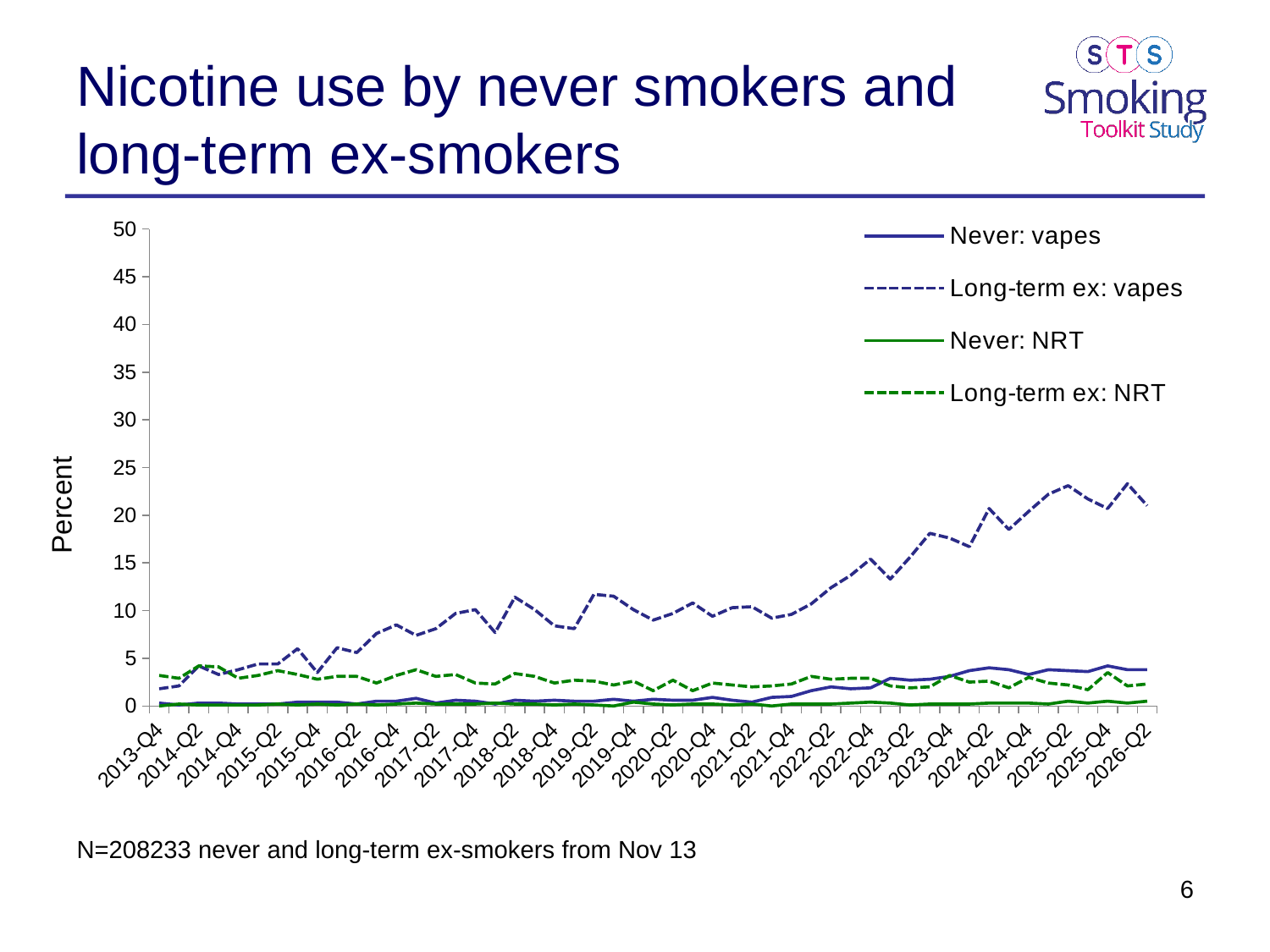
At 2024-Q2, which is larger: Never: vapes or Long-term ex: NRT? Never: vapes How many series does the legend list? 4 Is the value for Long-term ex: vapes at 2022-Q4 greater or less than 10? greater What is the label on the vertical axis? Percent Is the value for Never: vapes at 2024-Q2 greater or less than 5? less Is the value for Long-term ex: vapes at 2025-Q2 greater or less than 20? greater Does the Long-term ex: vapes series generally rise or fall from 2013-Q4 to 2026-Q2? rise Which series is drawn with a dashed dark blue line? Long-term ex: vapes Which series has the highest value at 2026-Q2? Long-term ex: vapes Which series has the lowest value at 2026-Q2? Never: NRT What kind of chart is shown on the slide? line chart